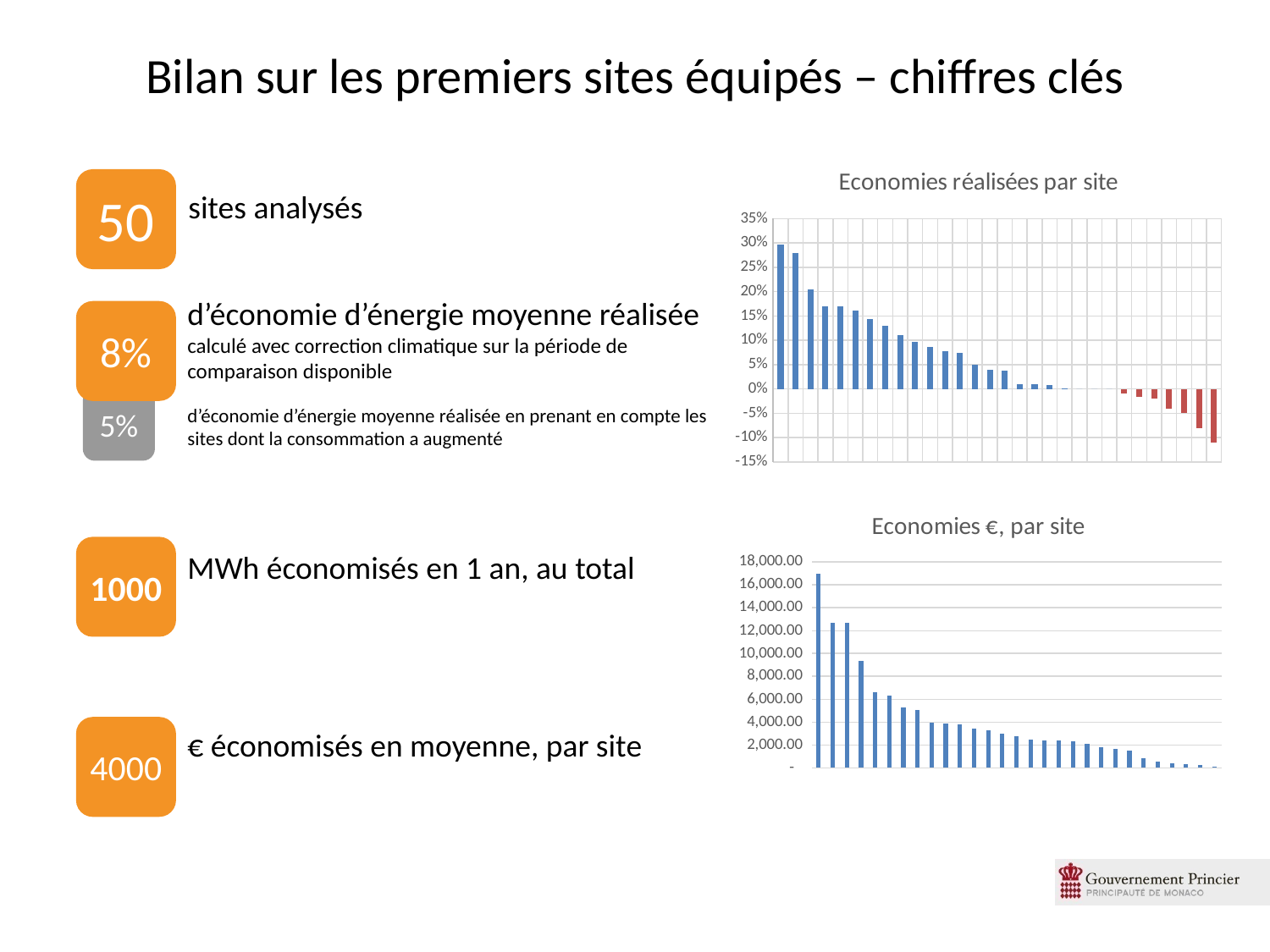
In the chart "Economies réalisées par site", is the value of the tallest bar greater or less than 25%? greater In the chart "Economies €, par site", is the value of the tallest bar greater or less than 14,000.00? greater In the chart "Economies €, par site", is the value of the second bar from the left greater or less than 14,000.00? less What kind of chart is "Economies €, par site"? bar chart What is the highest value shown on the y axis of the chart "Economies réalisées par site"? 35% What kind of chart is "Economies réalisées par site"? bar chart In the chart "Economies €, par site", do the values rise or fall from left to right along the x axis? fall In the chart "Economies réalisées par site", do the values rise or fall from left to right along the x axis? fall What is the highest value shown on the y axis of the chart "Economies €, par site"? 18,000.00